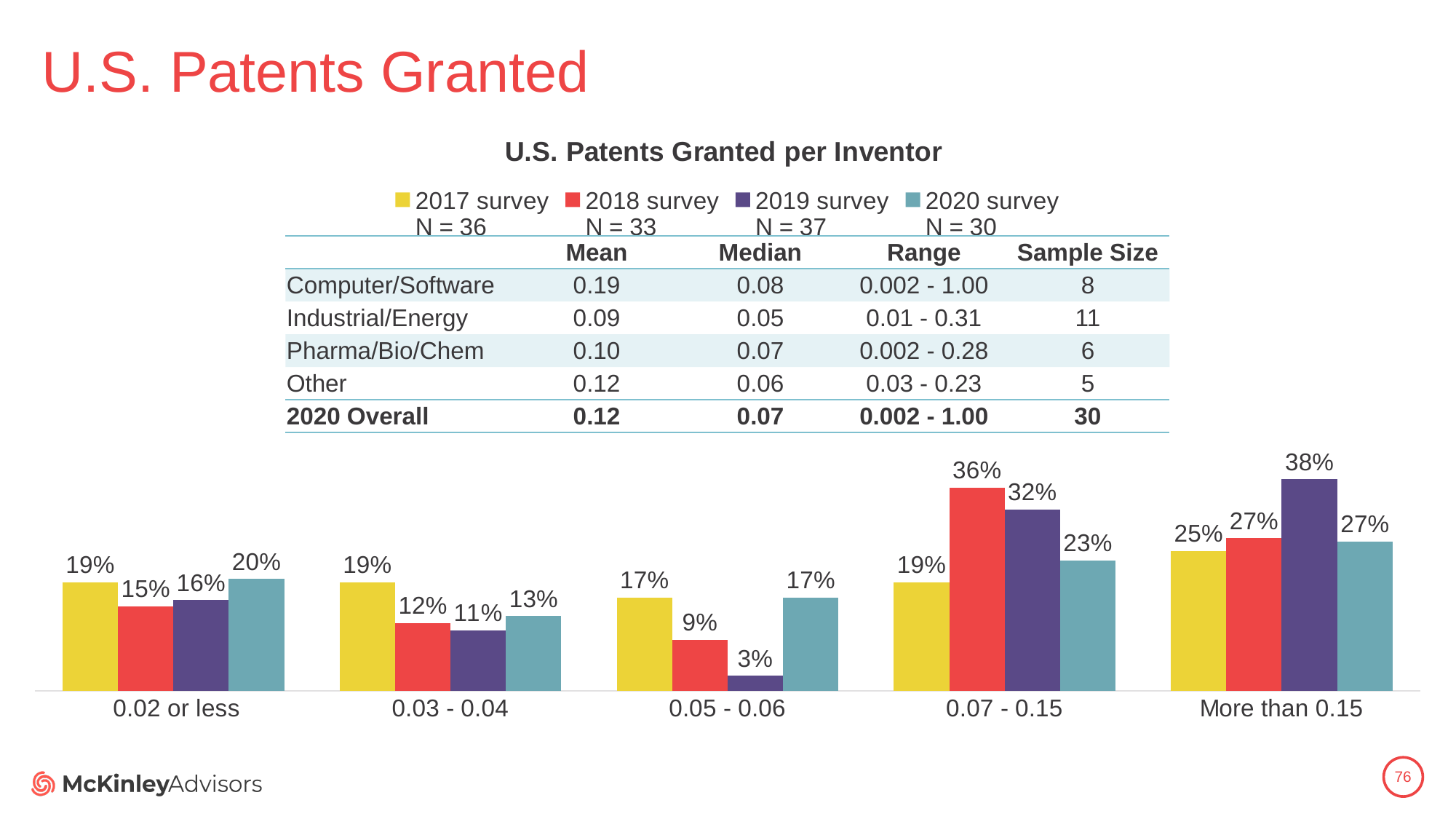
How many series does the legend list? 4 What is the 2018 survey value for the '0.07 - 0.15' category? 36% How many categories are shown on the x axis of the bar chart? 5 What is the sample size (N) for the 2019 survey shown in the legend? 37 What is the difference between the 2019 survey and 2020 survey values in the 'More than 0.15' category? 11% What is the 2019 survey value for the '0.05 - 0.06' category? 3% In the '0.03 - 0.04' category, which is larger: the 2017 survey value or the 2020 survey value? 2017 survey What is the title of the chart? U.S. Patents Granted per Inventor Which category has the highest value for the 2019 survey? More than 0.15 What percentage of the 2020 survey falls in the '0.02 or less' category? 20% Which category has the lowest value for the 2018 survey? 0.05 - 0.06 What kind of chart is shown on the slide? Bar chart